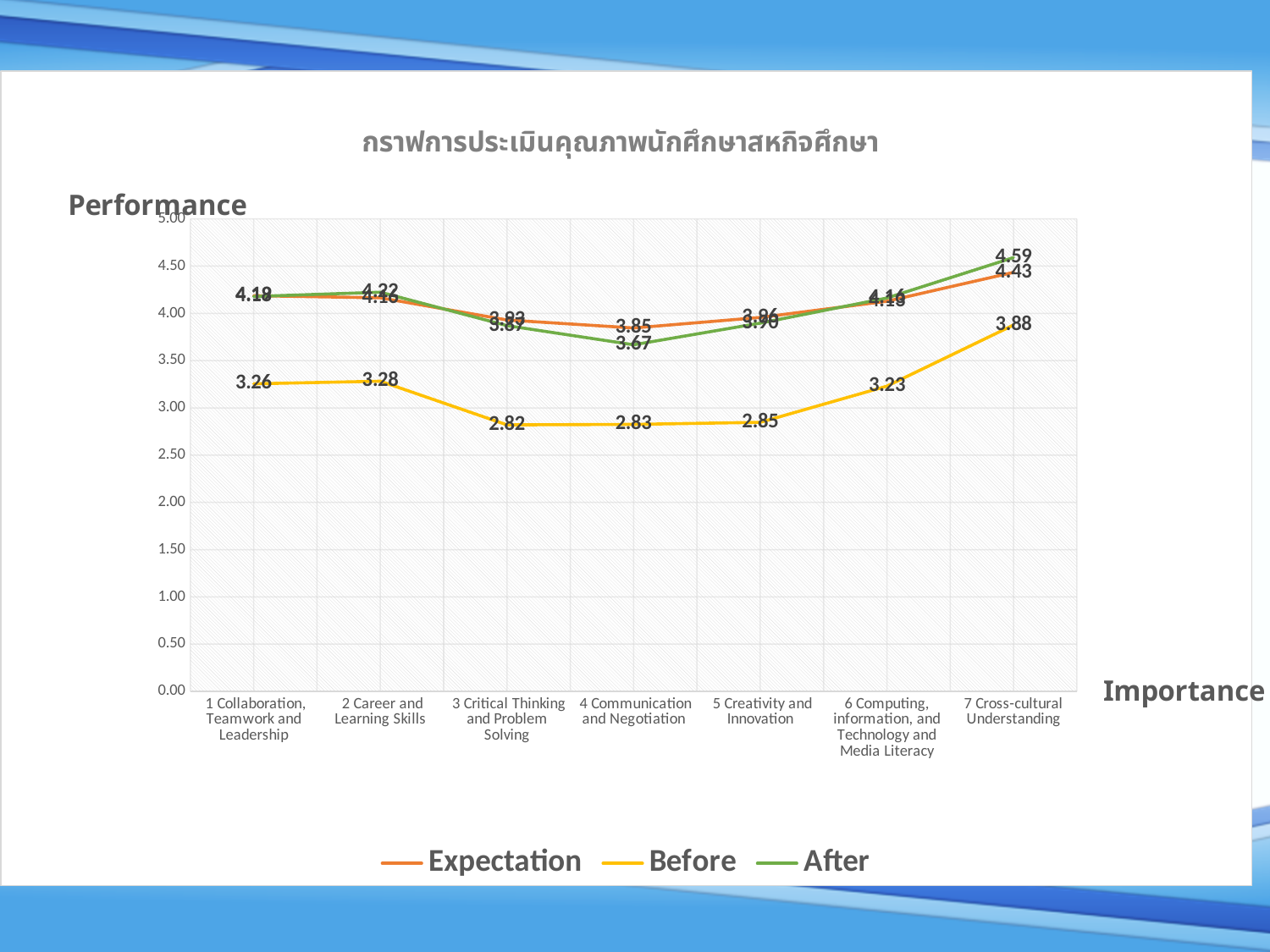
What is the Before value for 7 Cross-cultural Understanding? 3.88 What is the Expectation value for 7 Cross-cultural Understanding? 4.43 What is the difference between the Before values for 7 Cross-cultural Understanding and 6 Computing, information, and Technology and Media Literacy? 0.65 Which category has the highest Before value? 7 Cross-cultural Understanding What kind of chart is shown on the slide? Line chart For 4 Communication and Negotiation, which is larger, the Before value or the After value? After How many skill categories are plotted along the x axis? 7 What is the Before value for 3 Critical Thinking and Problem Solving? 2.82 What is the difference between the After and Expectation values for 7 Cross-cultural Understanding? 0.16 Is the Before value for 6 Computing, information, and Technology and Media Literacy greater or less than 3.00? greater What is the After value for 4 Communication and Negotiation? 3.67 How many series does the legend list? 3